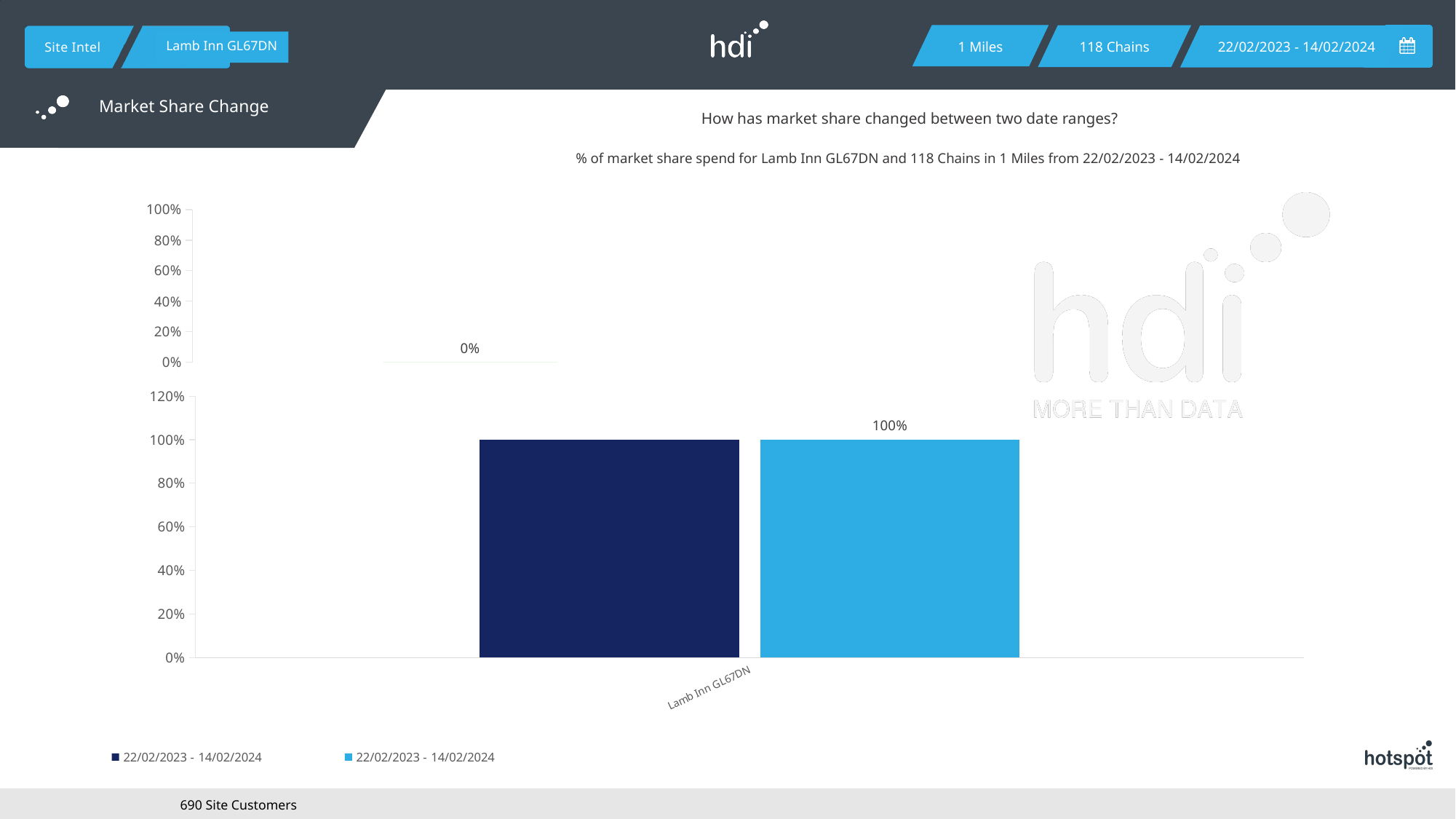
What kind of chart is the lower chart on the slide? bar chart What is the highest tick value on the y axis of the upper chart? 100% What category label appears on the x axis of the lower chart? Lamb Inn GL67DN In the lower chart, what is the value printed above the light blue bar for Lamb Inn GL67DN? 100% What is the data label shown on the upper chart? 0% In the lower chart, how many categories are shown on the x axis? 1 In the lower chart, is the value of the light blue bar for Lamb Inn GL67DN greater or less than 80%? greater In the lower chart, is the value of the dark blue bar for Lamb Inn GL67DN greater or less than 60%? greater How many series does the legend at the bottom of the slide list? 2 In the lower chart, what value does the dark blue bar for Lamb Inn GL67DN reach on the y axis? 100% What is the highest tick value on the y axis of the lower chart? 120%